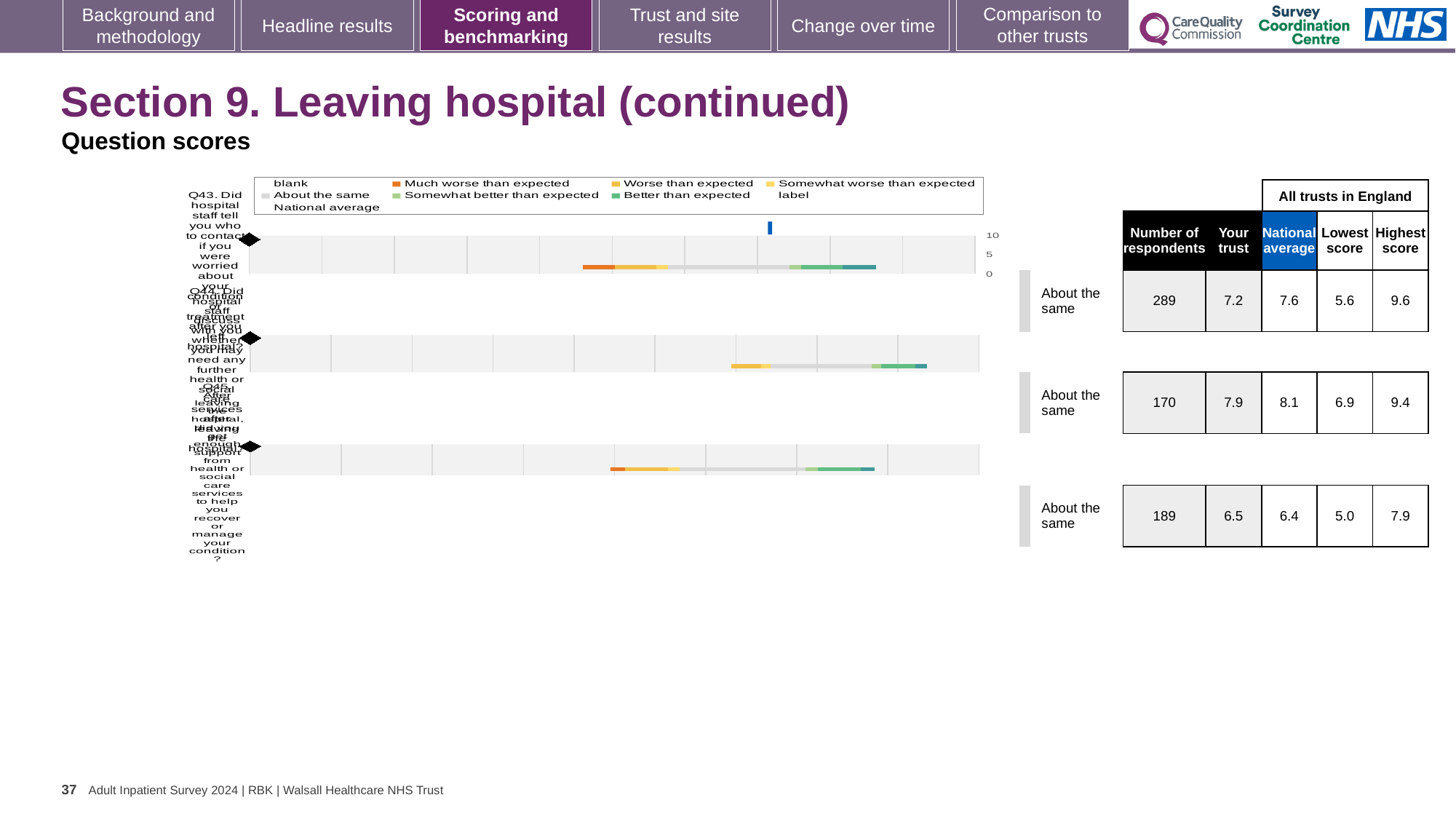
How many question charts (rows) are plotted on the slide? 3 For the top chart (Q43), what is the national average score shown in the table? 7.6 Which of the three charts has the lowest 'Your trust' score? Bottom chart (Q45), 6.5 For the top chart (Q43), which is larger: the 'Your trust' score or the national average? National average What kind of chart is used for the three question rows on the slide? bar chart What benchmark label is shown beside each of the three charts? About the same For the bottom chart (Q45), which is larger: the 'Your trust' score (6.5) or the national average (6.4)? Your trust Which of the three charts has the highest 'Your trust' score? Middle chart (Q44), 7.9 For the top chart (Q43), what is the 'Your trust' score shown in the table? 7.2 For the top chart (Q43), what is the difference between the national average (7.6) and the 'Your trust' score (7.2)? 0.4 For the middle chart (Q44), what is the highest score among all trusts in England? 9.4